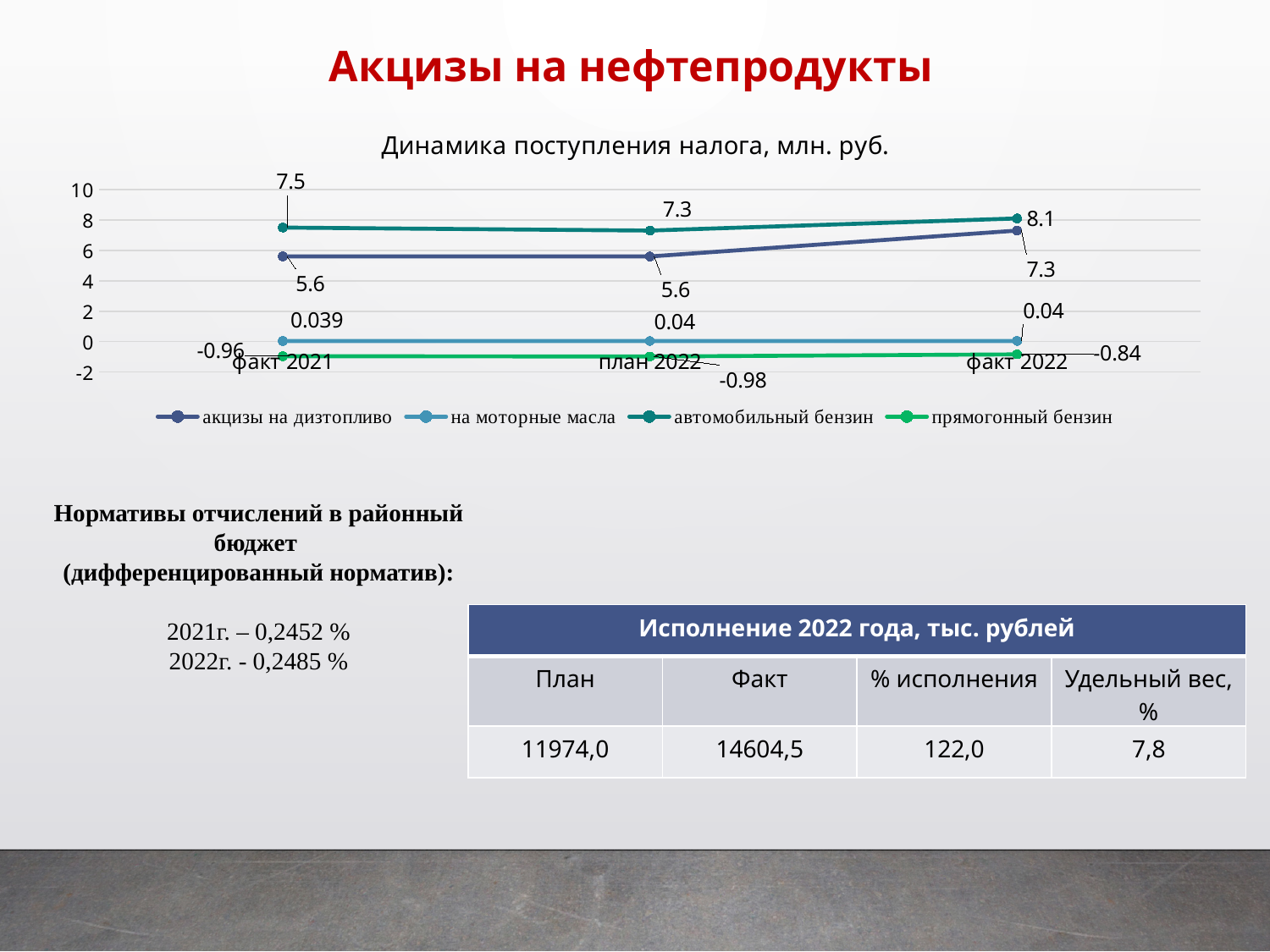
What is the value for автомобильный бензин at факт 2022? 8.1 What is the value for на моторные масла at факт 2021? 0.039 Which is larger at факт 2022: автомобильный бензин or акцизы на дизтопливо? автомобильный бензин What is the title of the chart? Динамика поступления налога, млн. руб. How many series does the chart legend list? 4 What is the difference between автомобильный бензин and акцизы на дизтопливо at факт 2021? 1.9 At which category is the value for прямогонный бензин lowest? план 2022 What type of chart is shown on the slide? line chart What is the value for прямогонный бензин at факт 2021? -0.96 At which category is the value for автомобильный бензин highest? факт 2022 What is the value for акцизы на дизтопливо at план 2022? 5.6 How many categories are shown on the x axis of the chart? 3